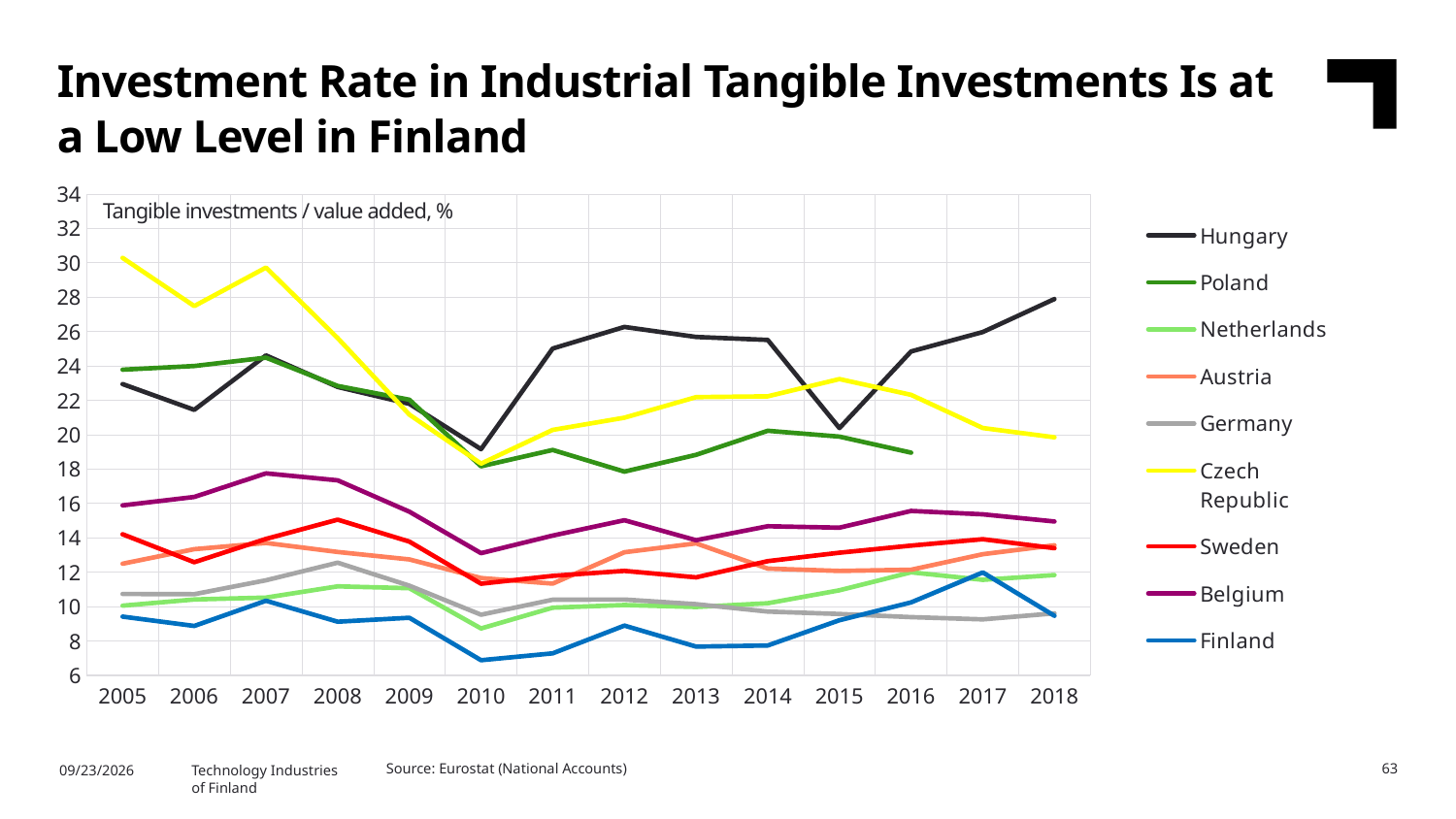
Which country has the lowest value in 2010? Finland Does the Czech Republic line rise or fall from 2005 to 2010? Fall Is the value for Czech Republic in 2005 greater or less than 28? greater Which country has the highest value in 2018? Hungary Which country has the highest value in 2005? Czech Republic How many years are shown on the x axis? 14 In 2015, which is larger: the value for Hungary or the value for Czech Republic? Czech Republic What label is printed inside the plot area describing the measure? Tangible investments / value added, % What kind of chart is shown on the slide? Line chart Is the value for Finland in 2010 greater or less than 8? less How many series does the legend list? 9 Is the value for Hungary in 2018 greater or less than 26? greater